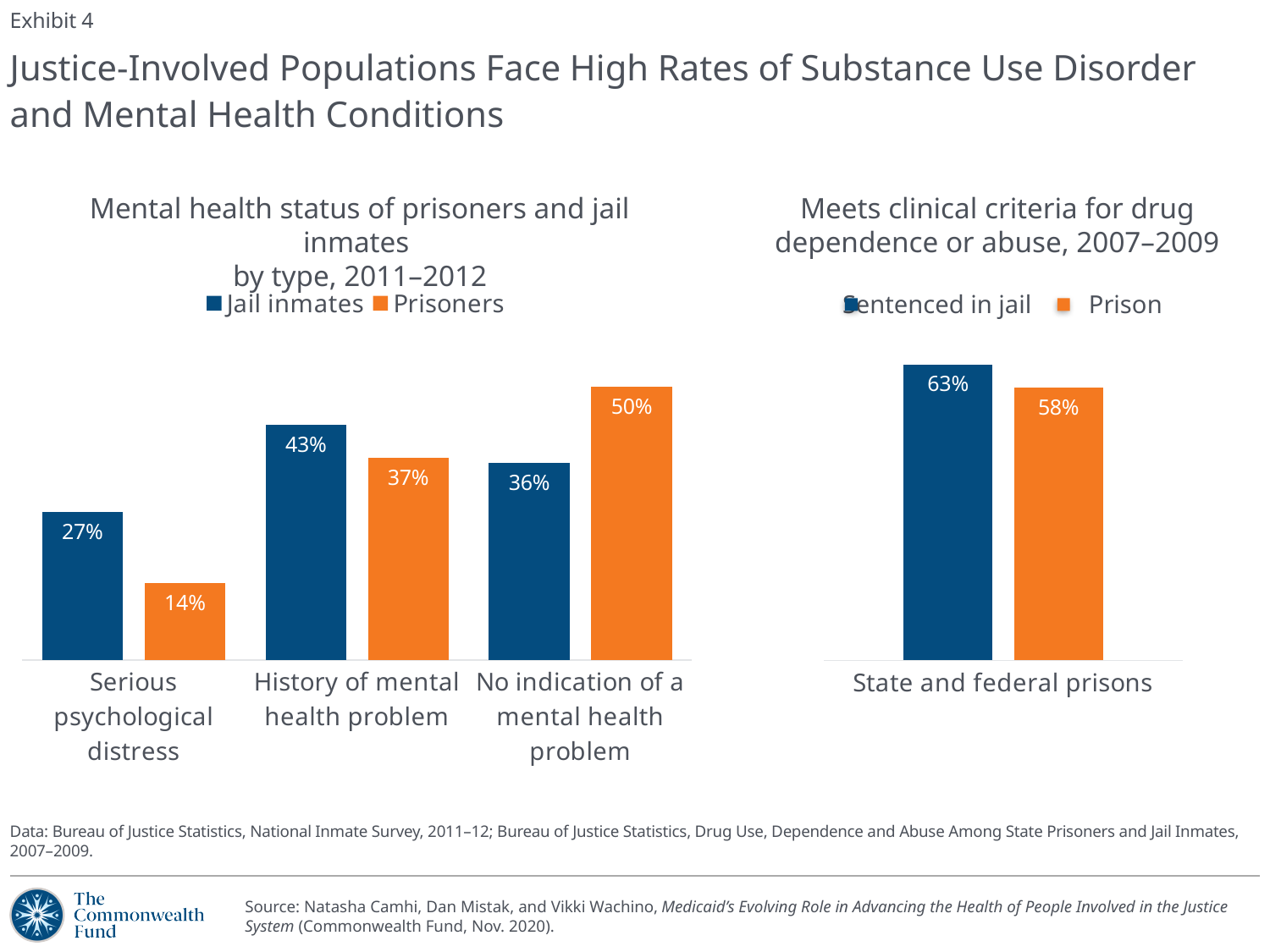
In the left chart (Mental health status of prisoners and jail inmates by type, 2011–2012), what is the difference between Jail inmates and Prisoners for serious psychological distress? 13% In the left chart (Mental health status of prisoners and jail inmates by type, 2011–2012), what is the value for Jail inmates with serious psychological distress? 27% In the left chart (Mental health status of prisoners and jail inmates by type, 2011–2012), what is the value for Prisoners with a history of mental health problem? 37% In the right chart (Meets clinical criteria for drug dependence or abuse, 2007–2009), what is the value for Sentenced in jail? 63% In the left chart (Mental health status of prisoners and jail inmates by type, 2011–2012), how many series does the legend list? 2 In the right chart (Meets clinical criteria for drug dependence or abuse, 2007–2009), what is the difference between Sentenced in jail and Prison? 5% In the left chart (Mental health status of prisoners and jail inmates by type, 2011–2012), what is the value for Prisoners with no indication of a mental health problem? 50% What kind of chart is the right chart (Meets clinical criteria for drug dependence or abuse, 2007–2009)? Bar chart In the left chart (Mental health status of prisoners and jail inmates by type, 2011–2012), how many categories are shown on the x axis? 3 In the right chart (Meets clinical criteria for drug dependence or abuse, 2007–2009), what is the value for Prison? 58% In the left chart (Mental health status of prisoners and jail inmates by type, 2011–2012), which category has the lowest value for Prisoners? Serious psychological distress In the left chart (Mental health status of prisoners and jail inmates by type, 2011–2012), which is larger for history of mental health problem: Jail inmates or Prisoners? Jail inmates